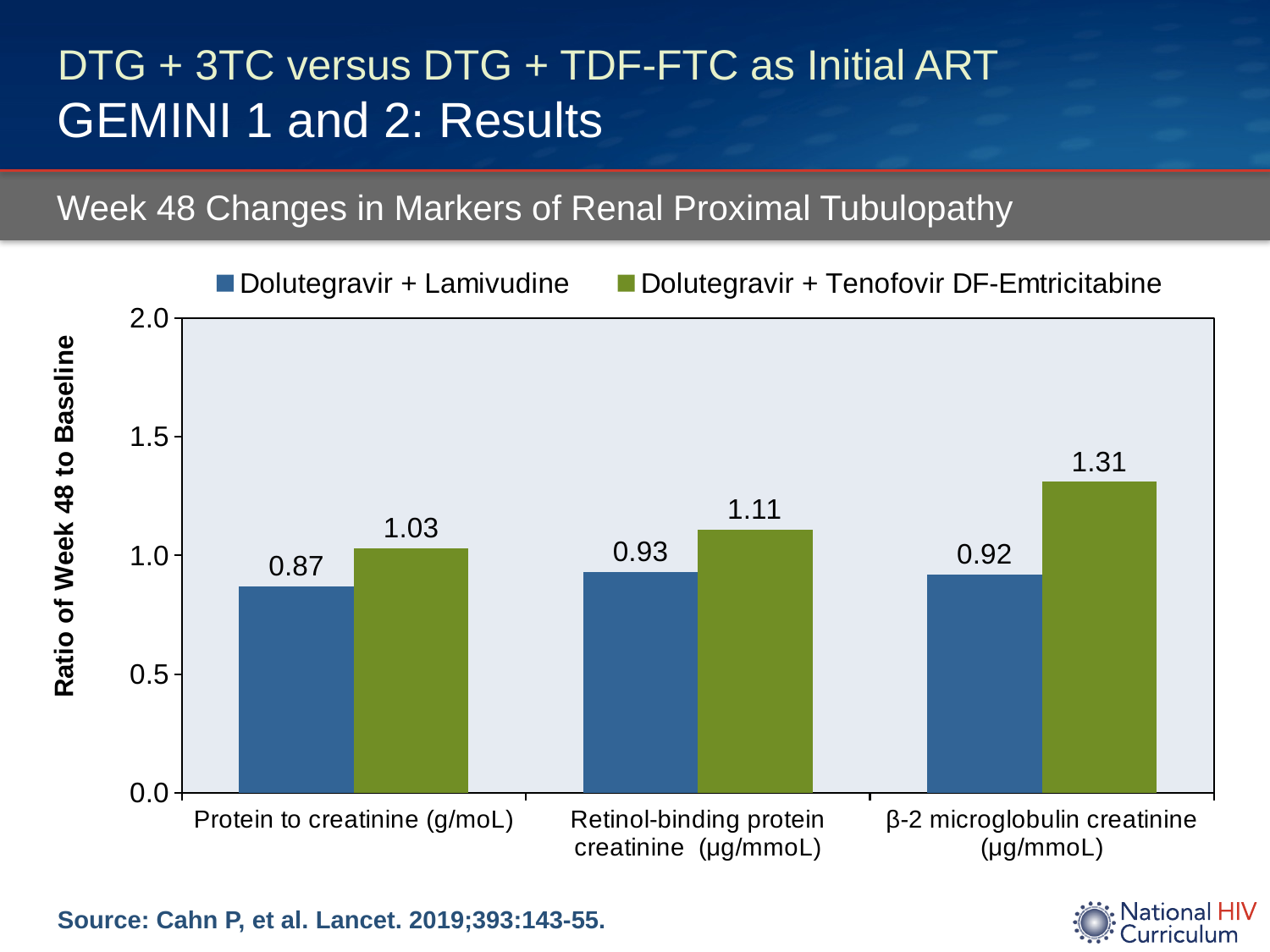
What is the ratio of Week 48 to baseline for Protein to creatinine (g/moL) in the Dolutegravir + Lamivudine group? 0.87 How many markers are shown on the x axis of the chart? 3 How many series does the legend list? 2 Which marker has the highest ratio of Week 48 to baseline in the Dolutegravir + Tenofovir DF-Emtricitabine group? β-2 microglobulin creatinine (µg/mmoL) Is the Dolutegravir + Lamivudine value for Retinol-binding protein creatinine (µg/mmoL) greater or less than 1.0? less What kind of chart is shown on the slide? Bar chart What is the ratio of Week 48 to baseline for Retinol-binding protein creatinine (µg/mmoL) in the Dolutegravir + Lamivudine group? 0.93 What is the ratio of Week 48 to baseline for β-2 microglobulin creatinine (µg/mmoL) in the Dolutegravir + Tenofovir DF-Emtricitabine group? 1.31 What is the label of the y axis of the chart? Ratio of Week 48 to Baseline What is the difference between the Dolutegravir + Tenofovir DF-Emtricitabine and Dolutegravir + Lamivudine ratios for β-2 microglobulin creatinine (µg/mmoL)? 0.39 For Protein to creatinine (g/moL), which group has the larger ratio of Week 48 to baseline? Dolutegravir + Tenofovir DF-Emtricitabine Which marker has the lowest ratio of Week 48 to baseline in the Dolutegravir + Lamivudine group? Protein to creatinine (g/moL)